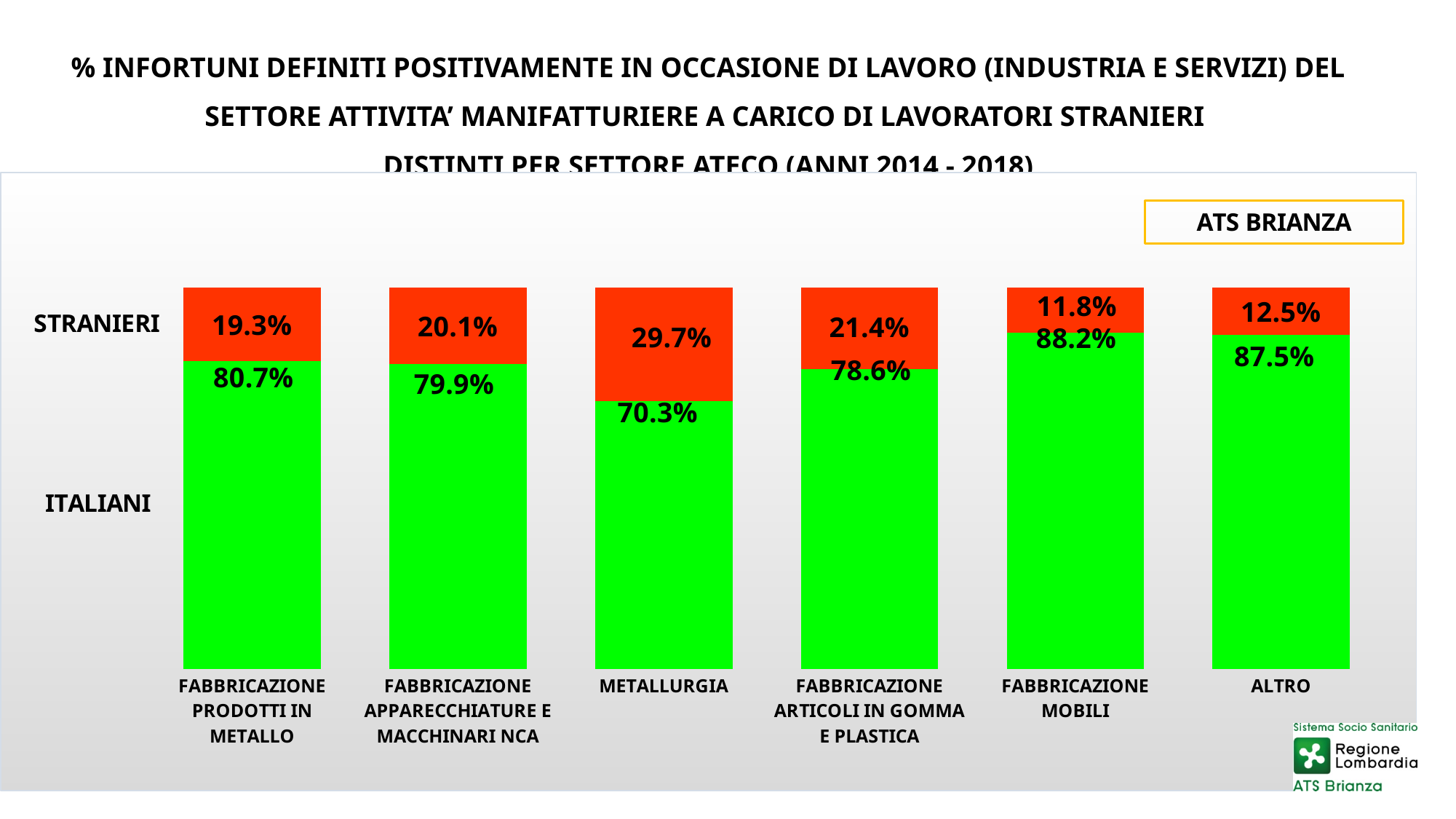
How many sectors are shown on the x axis? 6 What is the STRANIERI share for METALLURGIA? 29.7% Which sector has the lowest STRANIERI share? FABBRICAZIONE MOBILI What is the ITALIANI share for ALTRO? 87.5% What is the ITALIANI share for FABBRICAZIONE MOBILI? 88.2% Which sector has the highest STRANIERI share? METALLURGIA Which is larger: the STRANIERI share for FABBRICAZIONE APPARECCHIATURE E MACCHINARI NCA or for ALTRO? FABBRICAZIONE APPARECCHIATURE E MACCHINARI NCA How many series does the chart show? 2 What is the difference between the STRANIERI share for METALLURGIA and for FABBRICAZIONE ARTICOLI IN GOMMA E PLASTICA? 8.3% What is the STRANIERI share for FABBRICAZIONE PRODOTTI IN METALLO? 19.3% What kind of chart is this? stacked bar chart What is the total of the stacked bar for FABBRICAZIONE ARTICOLI IN GOMMA E PLASTICA? 100%